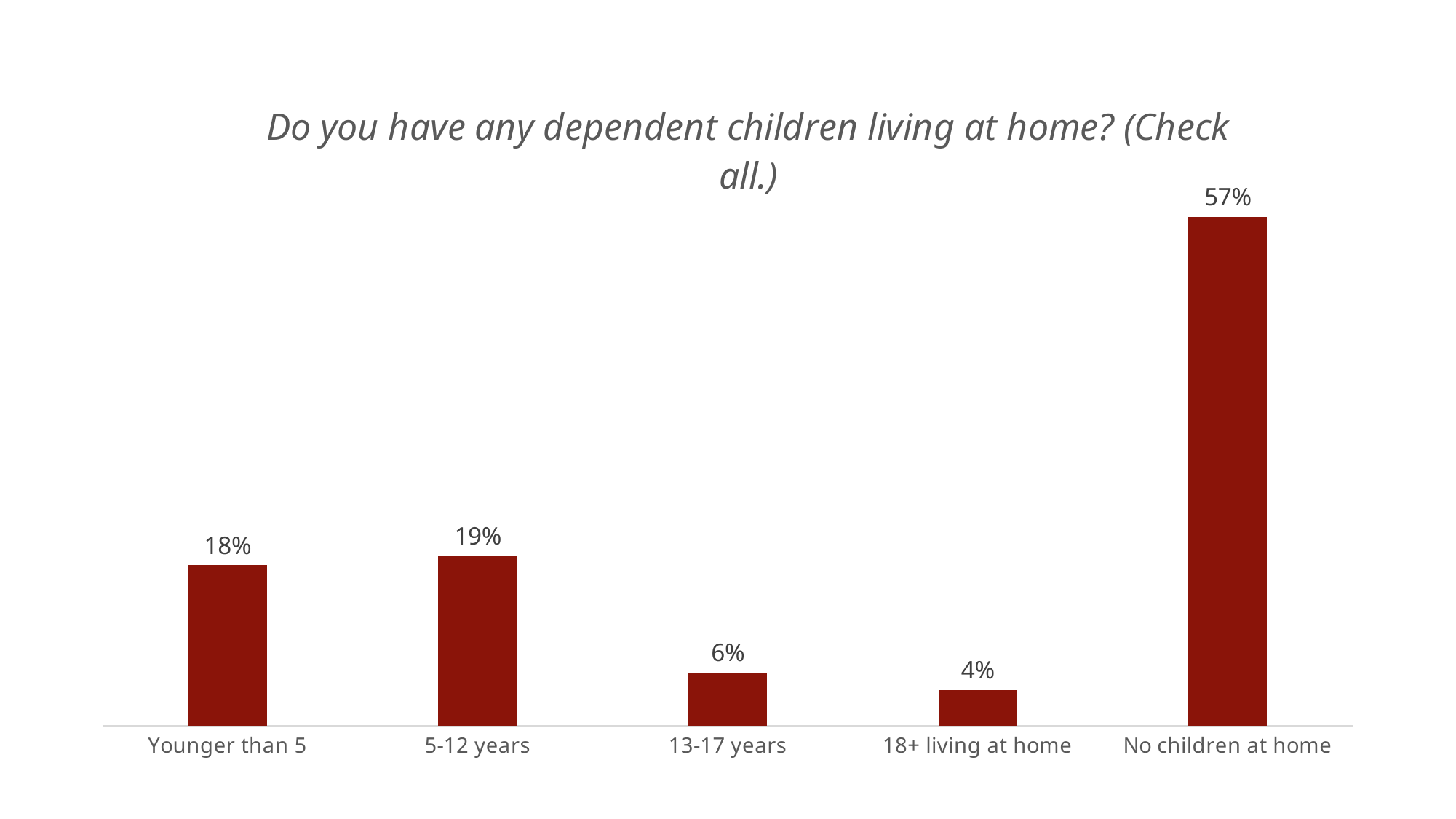
What is the value for the 5-12 years category? 19% What percentage of respondents have children younger than 5 living at home? 18% What kind of chart is shown on the slide? Bar chart What percentage of respondents have no children at home? 57% What percentage is shown for 13-17 years? 6% Which category has the highest value? No children at home Which category has the lowest value? 18+ living at home Which is larger, the value for 13-17 years or the value for 18+ living at home? 13-17 years How many categories are shown on the x axis? 5 What is the title of the chart? Do you have any dependent children living at home? (Check all.) What is the difference between the No children at home value and the 5-12 years value? 38% What is the value for 18+ living at home? 4%